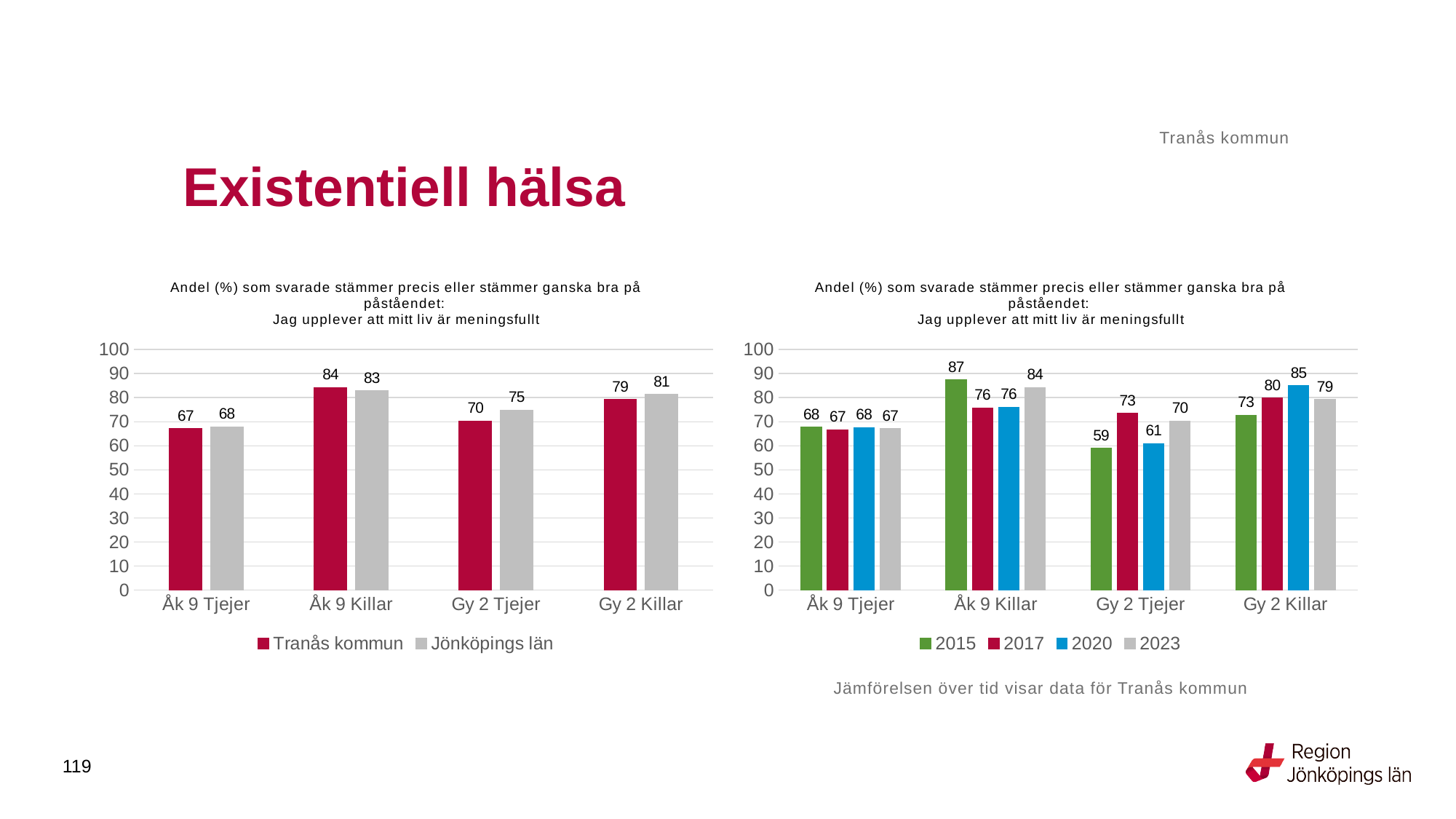
In the right chart, how many series does the legend list? 4 In the left chart, which category has the lowest value for Jönköpings län? Åk 9 Tjejer In the right chart, which is larger for Gy 2 Killar: 2020 or 2023? 2020 In the left chart, what is the value for Jönköpings län for Gy 2 Tjejer? 75 What kind of chart is the right chart? Bar chart In the right chart, what is the value for 2020 for Gy 2 Tjejer? 61 In the left chart, what is the value for Tranås kommun for Åk 9 Killar? 84 In the left chart, what is the difference between Jönköpings län and Tranås kommun for Gy 2 Tjejer? 5 In the right chart, what is the value for 2015 for Åk 9 Killar? 87 In the left chart, which category has the highest value for Tranås kommun? Åk 9 Killar In the left chart, how many series does the legend list? 2 In the right chart, which year has the lowest value for Gy 2 Tjejer? 2015